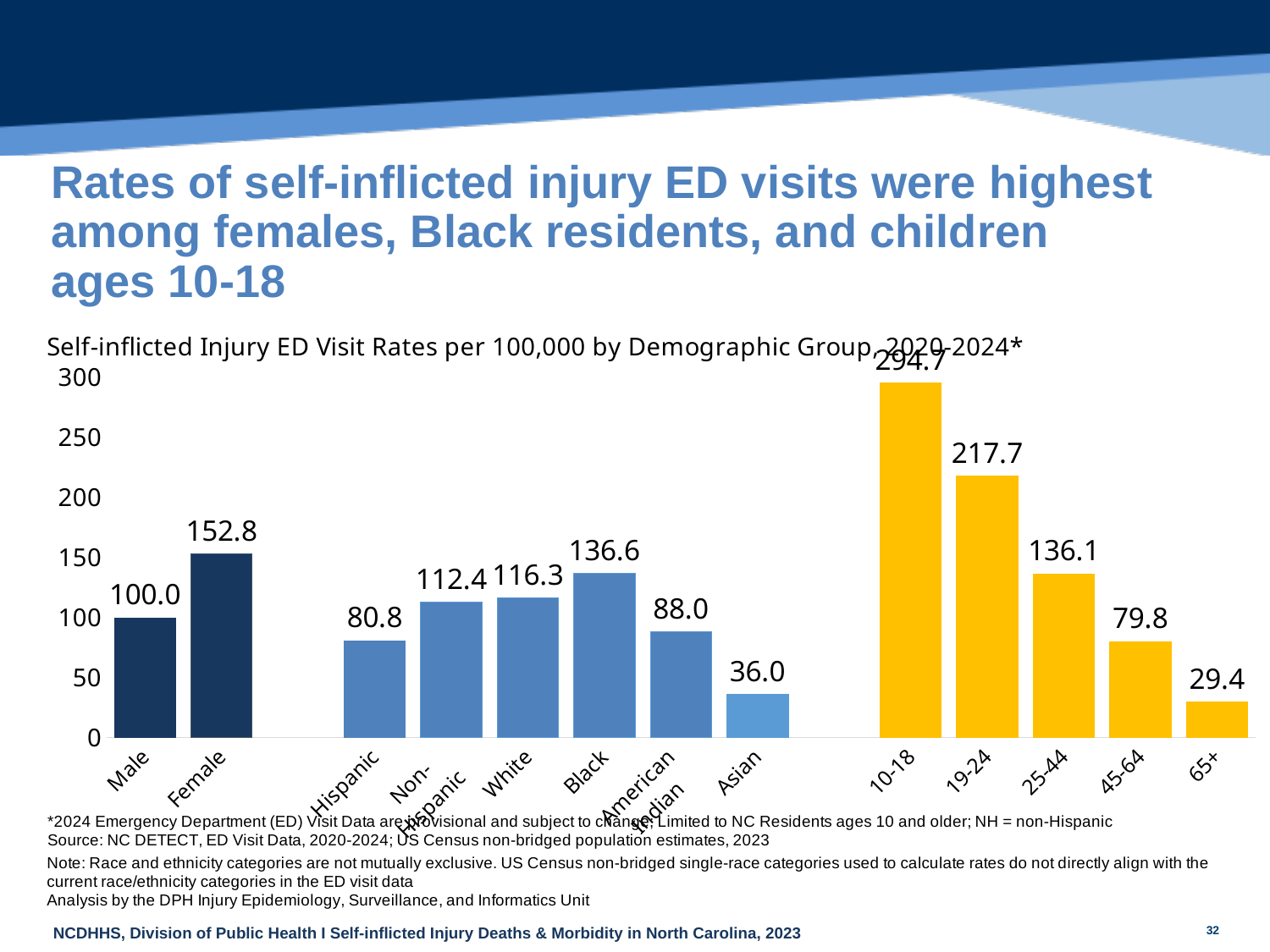
What is the ED visit rate for Asian residents? 36.0 What is the difference between the ED visit rates for the 10-18 and 19-24 age groups? 77.0 What is the ED visit rate for the 10-18 age group? 294.7 How many demographic groups are shown in the chart? 13 What is the self-inflicted injury ED visit rate per 100,000 for females? 152.8 Which demographic group has the lowest ED visit rate? 65+ Is the ED visit rate for Hispanic residents greater or less than 100? less What is the ED visit rate for the 45-64 age group? 79.8 Which demographic group has the highest ED visit rate? 10-18 What type of chart is shown on the slide? Bar chart What is the difference between the female and male ED visit rates? 52.8 Which has a higher ED visit rate, Black residents or White residents? Black